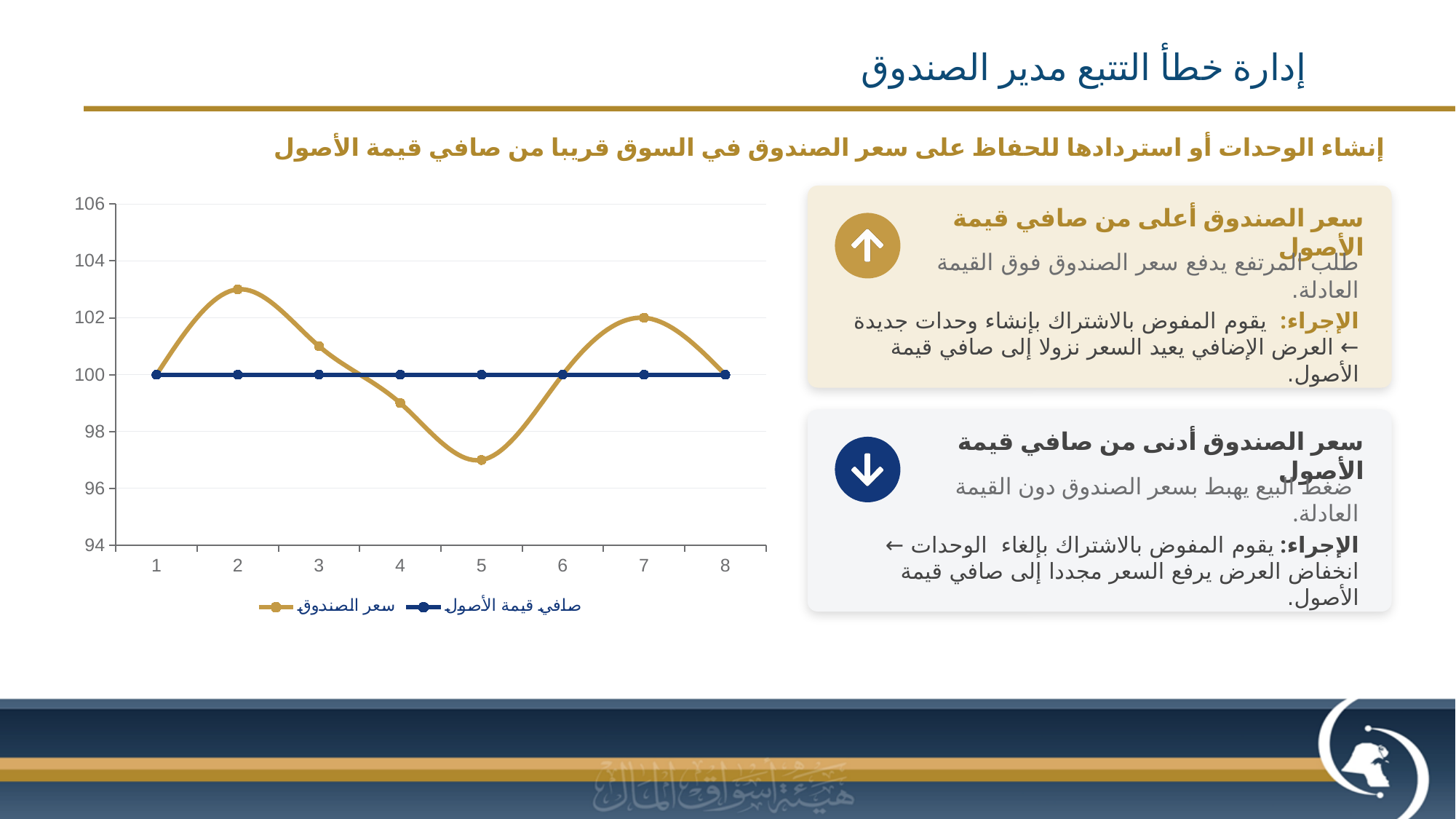
How many points are plotted along the x axis for each series? 8 At which x-axis point is سعر الصندوق highest? 2 How many series does the chart legend list? 2 What is the value of سعر الصندوق at point 1? 100 What is the value of صافي قيمة الأصول at point 4? 100 What is the difference between سعر الصندوق and صافي قيمة الأصول at point 7? 2 What kind of chart is shown on the slide? line chart What is the value of سعر الصندوق at point 7? 102 Is the value of سعر الصندوق at point 5 greater or less than 98? less Which is larger at point 7: سعر الصندوق or صافي قيمة الأصول? سعر الصندوق Is the value of سعر الصندوق at point 2 greater or less than 102? greater At which x-axis point is سعر الصندوق lowest? 5